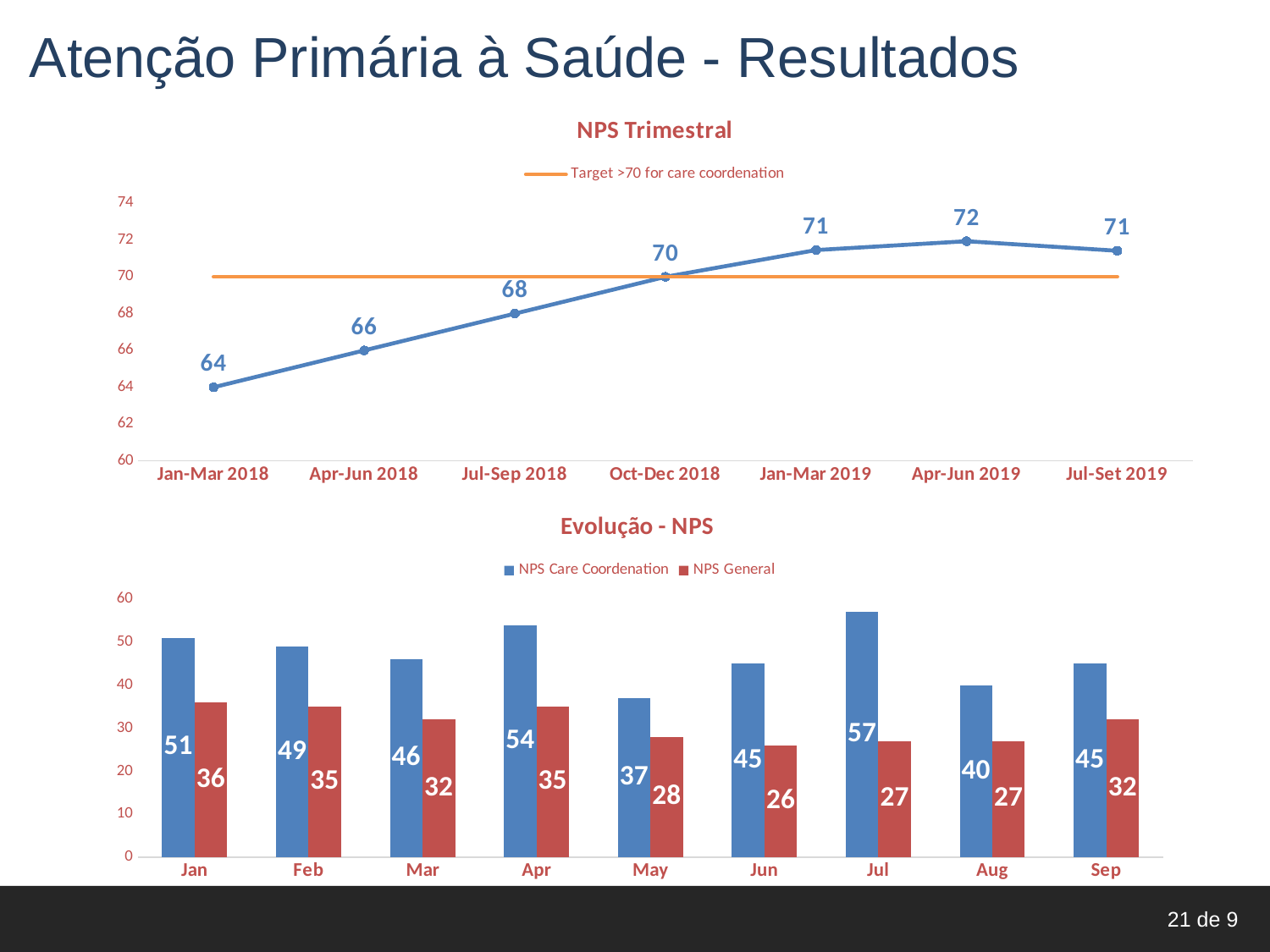
In the 'Evolução - NPS' chart, what is the NPS General value for May? 28 In the 'Evolução - NPS' chart, what is the difference between NPS Care Coordenation and NPS General in Jul? 30 In the 'Evolução - NPS' chart, which month has the highest NPS Care Coordenation value? Jul In the 'NPS Trimestral' chart, which quarter has the highest value? Apr-Jun 2019 In the 'Evolução - NPS' chart, how many series does the legend list? 2 In the 'NPS Trimestral' chart, what is the difference between the Apr-Jun 2019 value and the Jan-Mar 2018 value? 8 In the 'NPS Trimestral' chart, which quarter has the lowest value? Jan-Mar 2018 In the 'NPS Trimestral' chart, what is the value for Jul-Sep 2018? 68 In the 'NPS Trimestral' chart, how many quarters are plotted? 7 In the 'NPS Trimestral' chart, what target does the legend describe? Target >70 for care coordenation In the 'Evolução - NPS' chart, which month has the lowest NPS General value? Jun What kind of chart is 'Evolução - NPS'? Bar chart